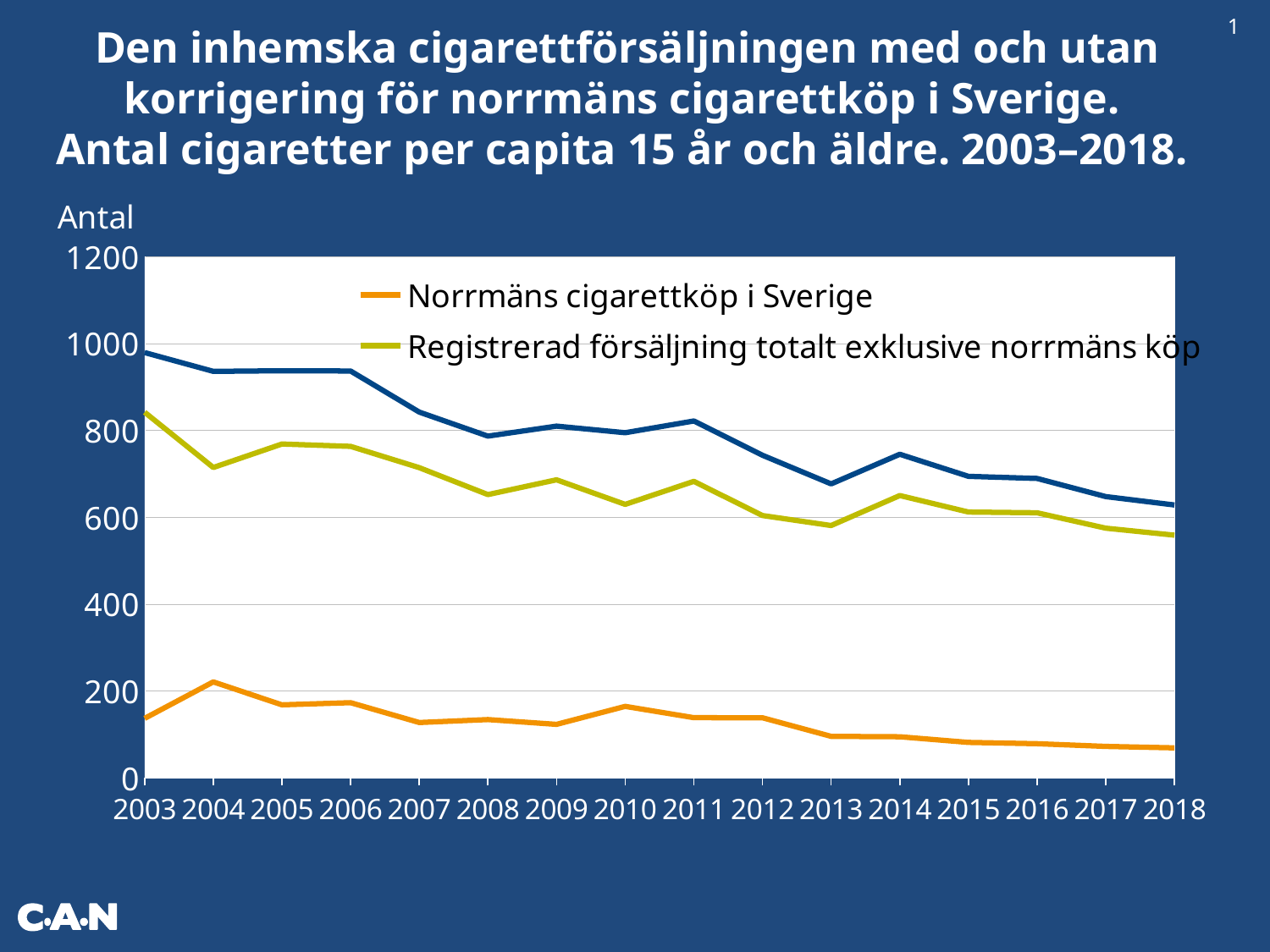
What colour is the line for Norrmäns cigarettköp i Sverige? orange Does the value for Registrerad försäljning totalt exklusive norrmäns köp generally rise or fall from 2003 to 2018? fall What kind of chart is shown on the slide? line chart How many series does the legend list? 2 In which year is the value for Norrmäns cigarettköp i Sverige highest? 2004 How many years are shown along the x axis? 16 Is the value for Norrmäns cigarettköp i Sverige in 2004 greater or less than 200? greater In which year is the value for Registrerad försäljning totalt exklusive norrmäns köp highest? 2003 Is the value for Registrerad försäljning totalt exklusive norrmäns köp in 2003 greater or less than 800? greater Is the value for Norrmäns cigarettköp i Sverige in 2018 greater or less than 200? less Which is larger for Registrerad försäljning totalt exklusive norrmäns köp: the value in 2003 or the value in 2018? 2003